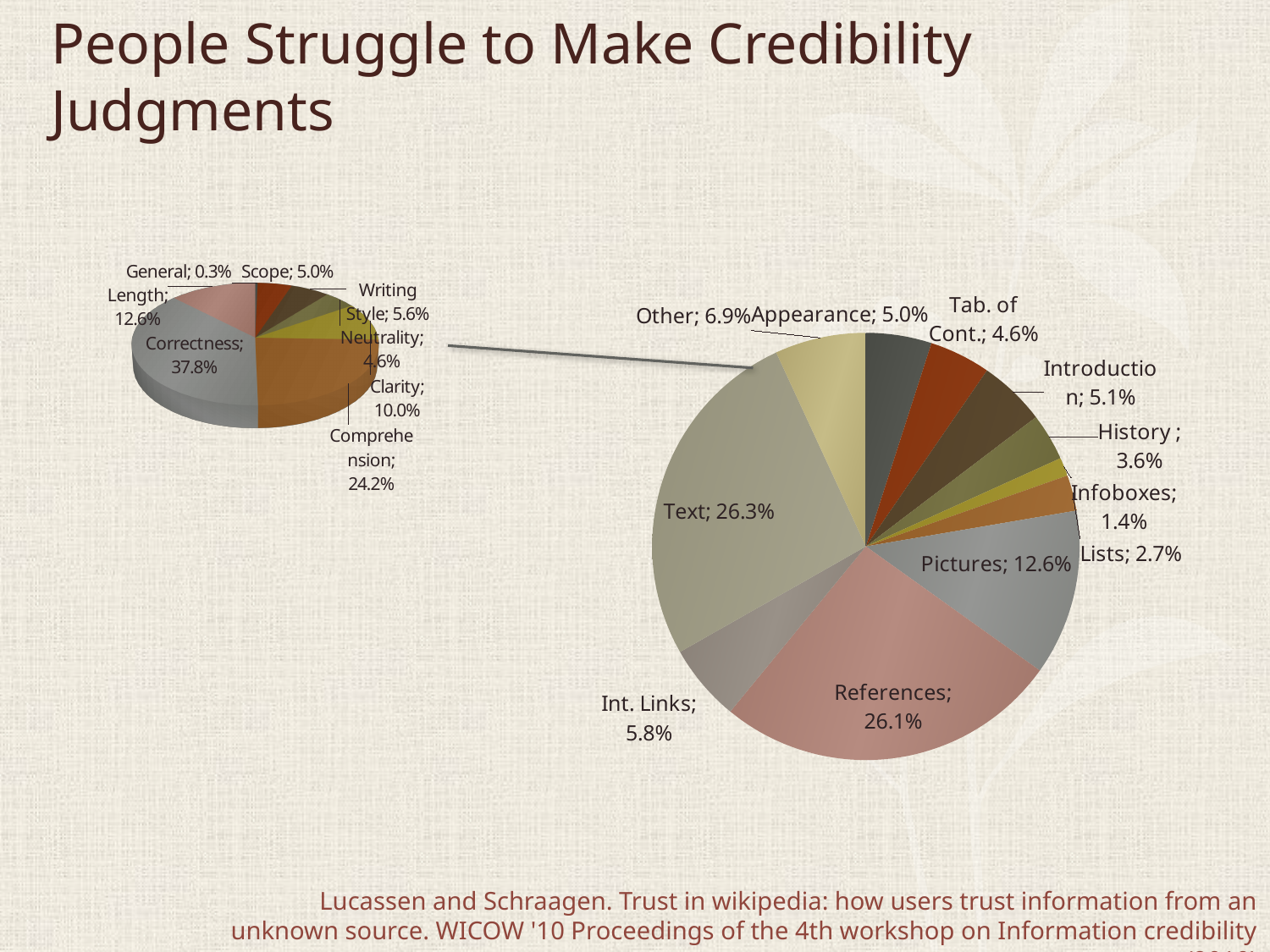
On the small pie chart on the left, which category has the largest share? Correctness What kind of chart is the large chart on the right? Pie chart On the large pie chart on the right, which category has the smallest share? Infoboxes On the small pie chart on the left, what is the value for Comprehension? 24.2% On the large pie chart on the right, which is larger, Pictures or Other? Pictures On the large pie chart on the right, what is the value for References? 26.1% On the small pie chart on the left, what is the value for Correctness? 37.8% On the small pie chart on the left, which category has the smallest share? General How many slices does the large pie chart on the right have? 11 On the large pie chart on the right, what is the difference between Pictures and Int. Links? 6.8% On the small pie chart on the left, which is larger, Clarity or Length? Length On the large pie chart on the right, what is the value for Text? 26.3%